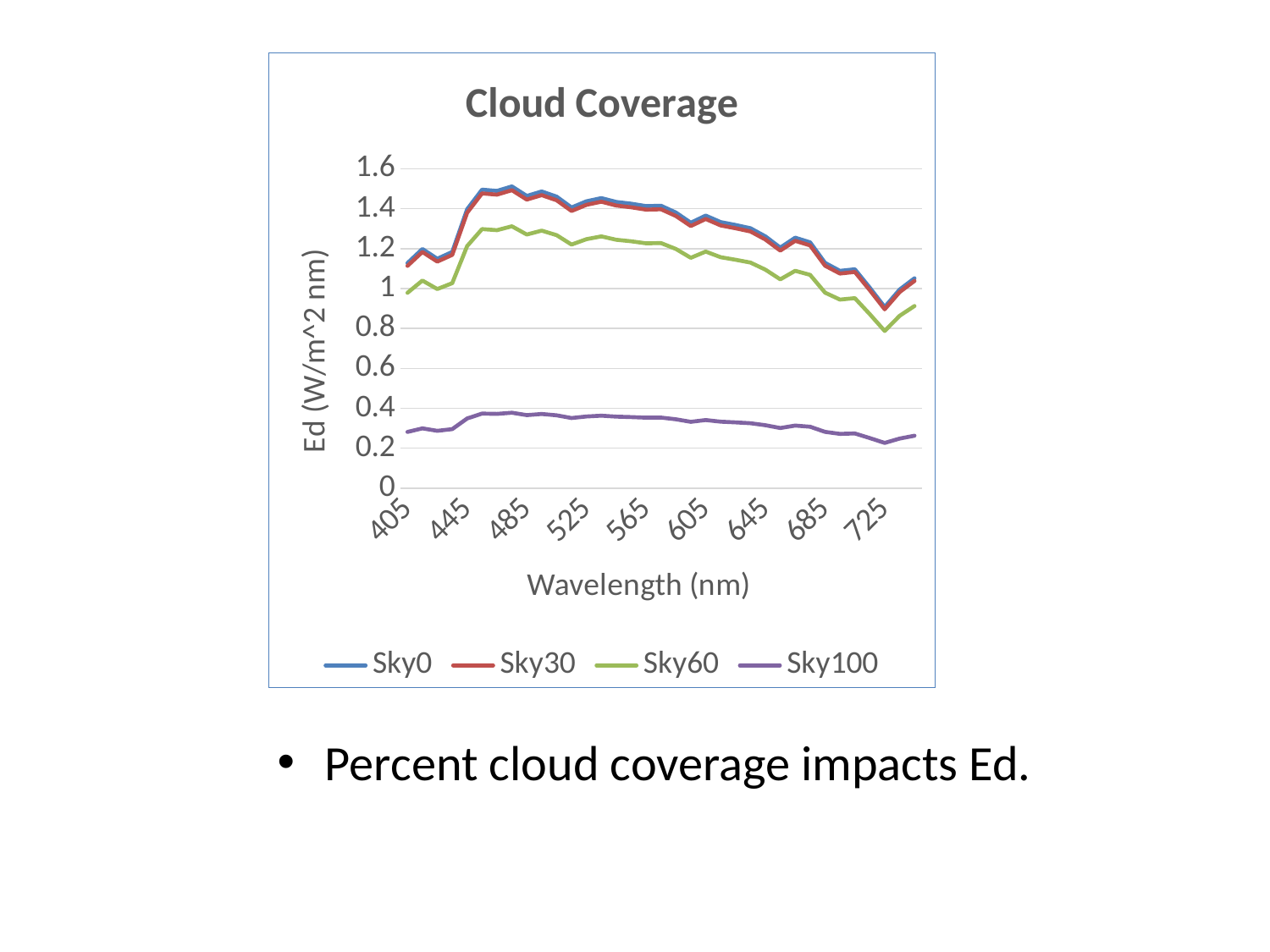
At 525 nm, which is larger, Sky0 or Sky100? Sky0 What is the title of the chart? Cloud Coverage What is the label of the y axis? Ed (W/m^2 nm) How many series does the legend of the Cloud Coverage chart list? 4 Is the value for Sky100 at 405 nm greater or less than 0.4? less Is the value for Sky60 at 725 nm greater or less than 1? less Is the value for Sky0 at 485 nm greater or less than 1.4? greater Do the Sky100 values rise or fall from 485 nm to 725 nm? fall What kind of chart is shown on the slide? line chart At 605 nm, which is larger, Sky60 or Sky100? Sky60 Which series has the lowest values across the whole wavelength range? Sky100